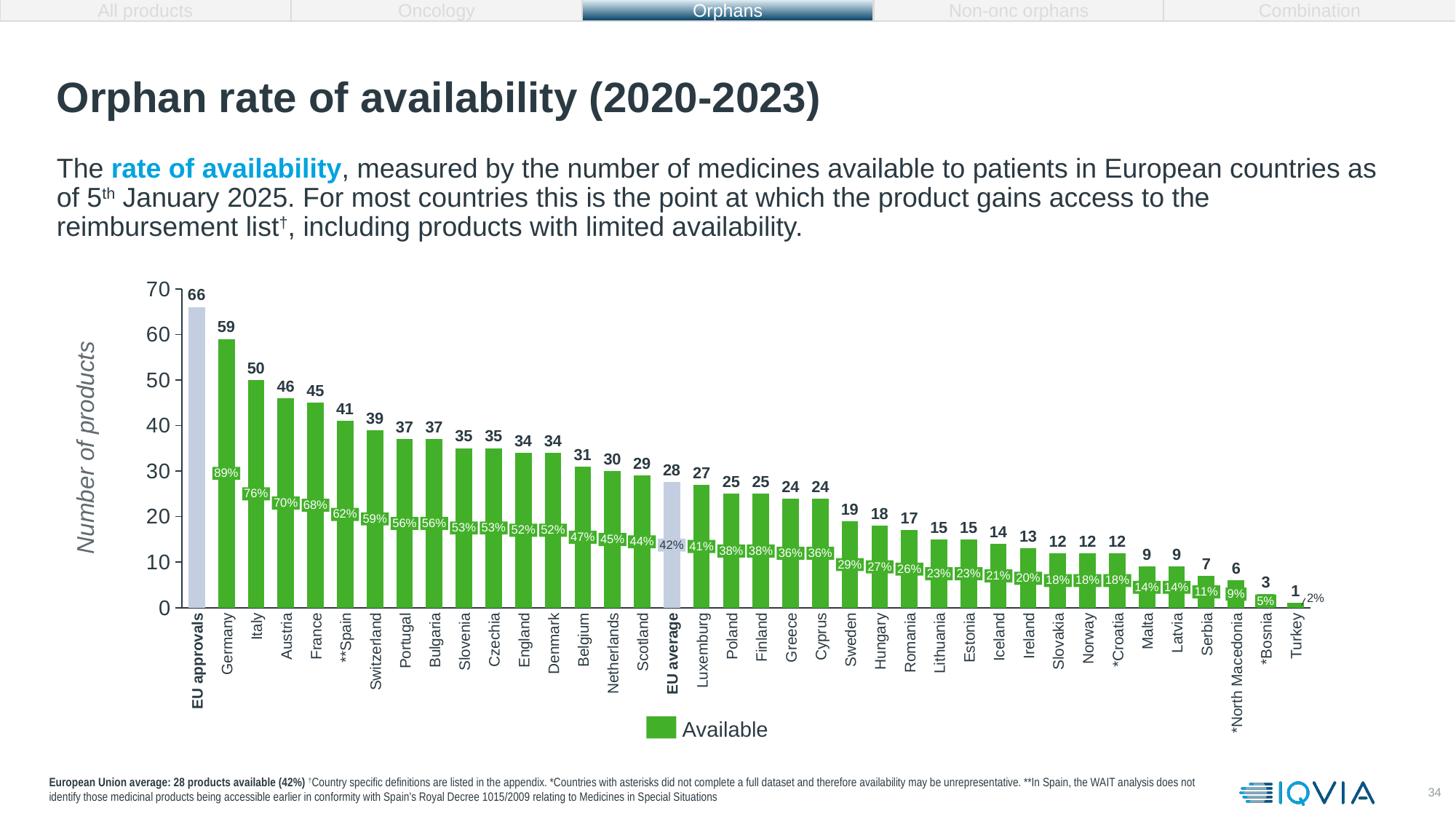
Do the values rise or fall moving from left to right along the x axis? Fall What is the number of products for Germany? 59 What percentage is shown on the bar for Italy? 76% What is the difference in number of products between EU approvals and Germany? 7 What type of chart is shown on the slide? Bar chart What is the number of products for Turkey? 1 How many bars are plotted in the chart? 38 Which has more products, France or Switzerland? France How many entries does the legend list? 1 Which category has the lowest number of products? Turkey Which country (excluding the EU approvals bar) has the highest number of products? Germany What is the number of products for the EU average? 28